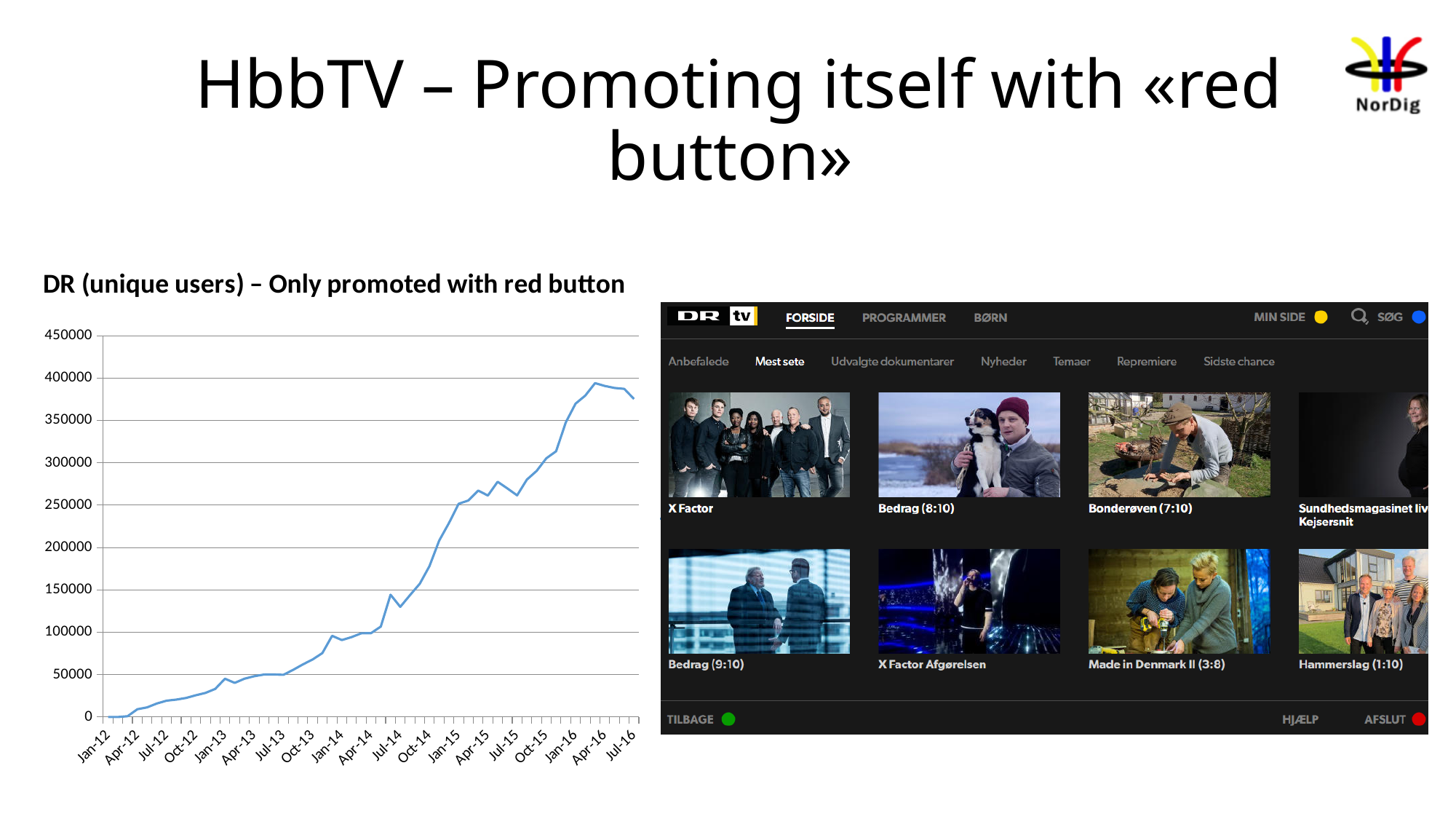
Is the value for Apr-15 greater or less than 250000? greater Which x-axis label has the lowest value on the chart? Jan-12 Which is larger, the value for Jan-15 or the value for Jan-14? Jan-15 How many date labels are shown along the x axis of the chart? 19 What is the highest value shown on the chart's vertical axis? 450000 Is the value for Jul-16 greater or less than 350000? greater Is the value for Oct-13 greater or less than 100000? less Do the values in the chart generally rise or fall from Jan-12 to Jul-16? rise What kind of chart is shown on the slide? line chart What is the title of the chart on the slide? DR (unique users) – Only promoted with red button